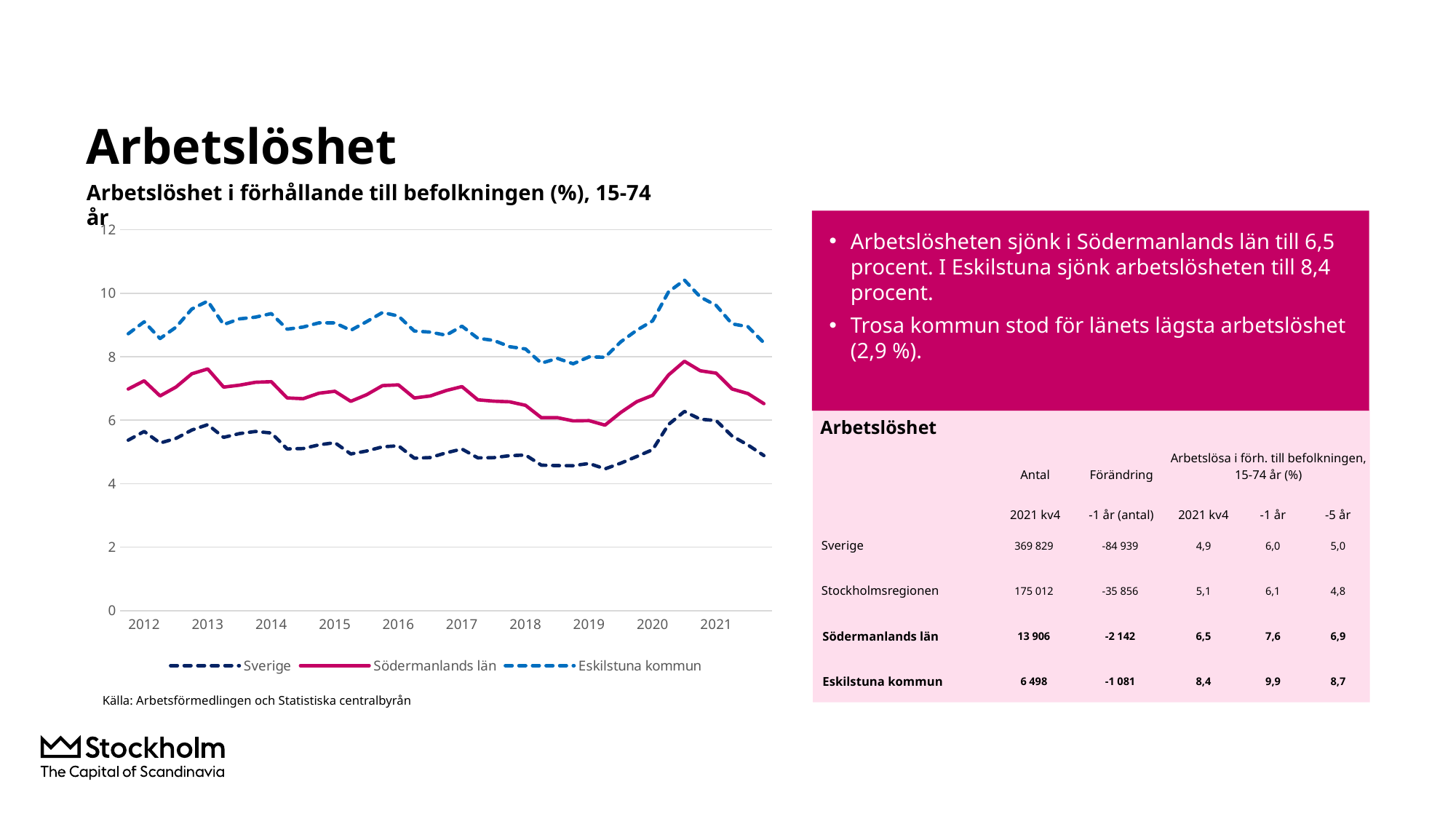
Which series has the highest values across the whole chart? Eskilstuna kommun Which series has the lowest values across the whole chart? Sverige Is the value for Södermanlands län at its 2020 peak greater or less than 8? less Is the value for Eskilstuna kommun at its 2020 peak greater or less than 10? greater What is the title of the chart? Arbetslöshet i förhållande till befolkningen (%), 15-74 år In 2020, which is larger: the value for Eskilstuna kommun or the value for Sverige? Eskilstuna kommun What kind of chart is shown on the slide? Line chart How many years are labelled on the x axis of the chart? 10 Which series are listed in the chart legend? Sverige, Södermanlands län, Eskilstuna kommun Is the value for Sverige at the start of 2012 greater or less than 6? less How many series does the chart legend list? 3 Does the Södermanlands län line rise or fall from its 2020 peak to the end of 2021? Fall